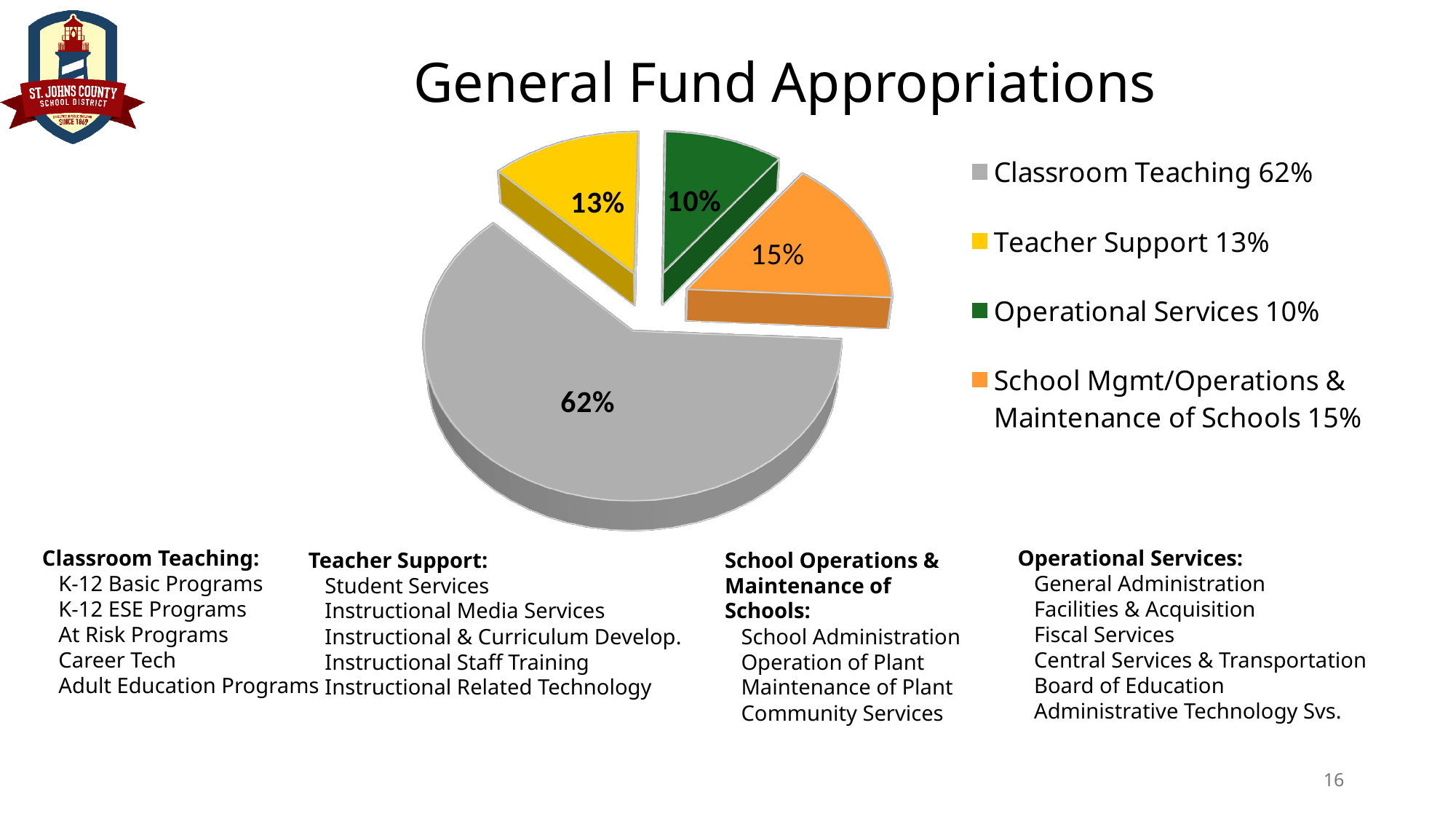
What share of General Fund Appropriations goes to Classroom Teaching? 62% What percentage is shown for School Mgmt/Operations & Maintenance of Schools? 15% How many slices does the pie chart have? 4 What type of chart is shown on the slide? Pie chart Which category has the smallest slice of the pie? Operational Services Which category has the largest slice of the pie? Classroom Teaching What is the difference in percentage points between Classroom Teaching and Teacher Support? 49 What colour is the Operational Services slice? Green What percentage of the pie is Teacher Support? 13% What is the difference in percentage points between School Mgmt/Operations & Maintenance of Schools and Operational Services? 5 Which is larger, Teacher Support or School Mgmt/Operations & Maintenance of Schools? School Mgmt/Operations & Maintenance of Schools What percentage is shown for Operational Services? 10%